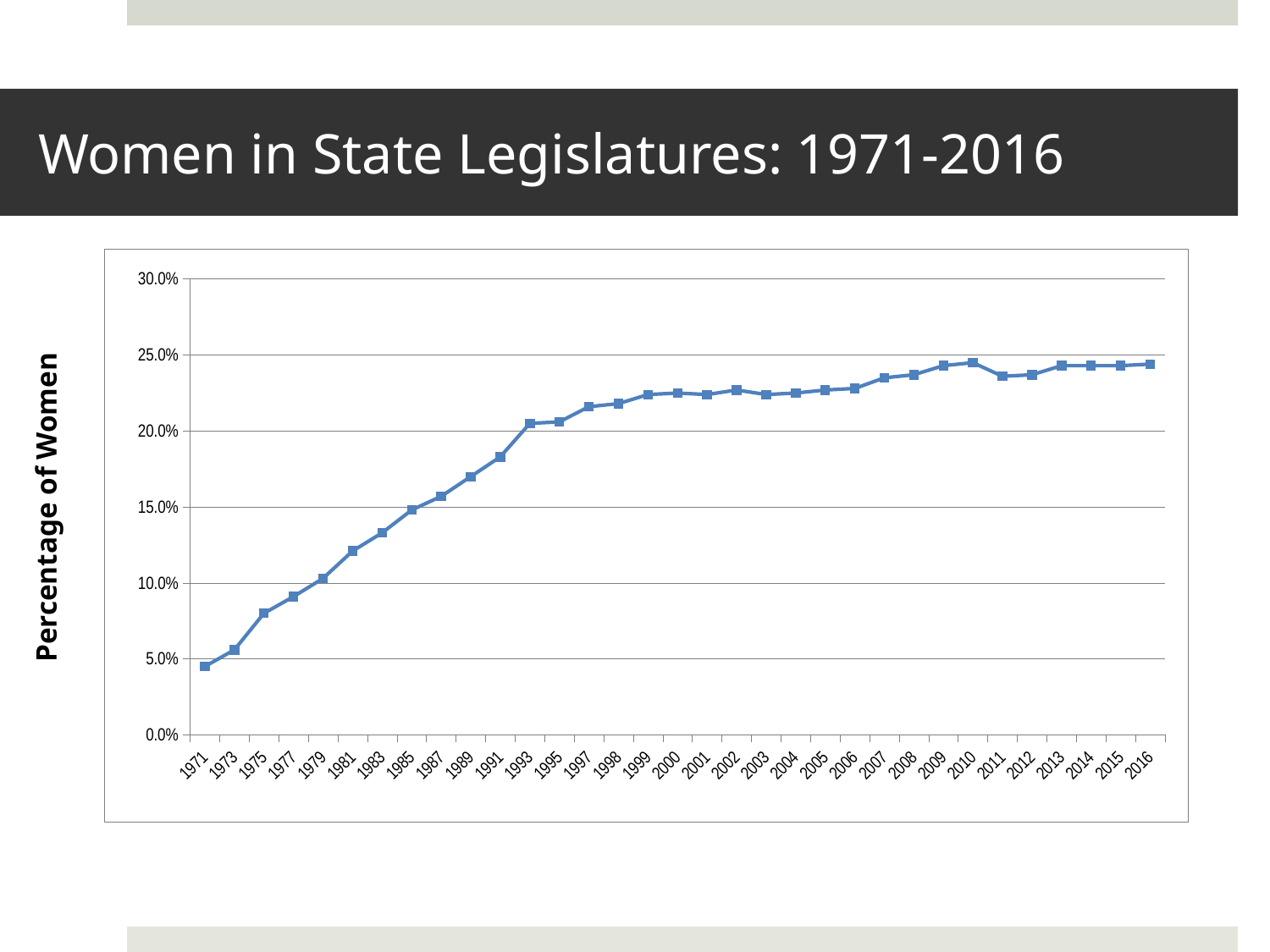
Is the value for 1993 greater or less than 20.0%? greater What is the title of the slide containing the chart? Women in State Legislatures: 1971-2016 Does the percentage of women in state legislatures generally rise or fall from 1971 to 2016? rise Is the value for 2016 greater or less than 25.0%? less What kind of chart is shown on the slide? line chart How many years are plotted along the x axis? 33 What is the label on the y axis of the chart? Percentage of Women Is the value for 1971 greater or less than 5.0%? less Which year has the larger value, 1981 or 1991? 1991 Which year has the lowest percentage of women in state legislatures? 1971